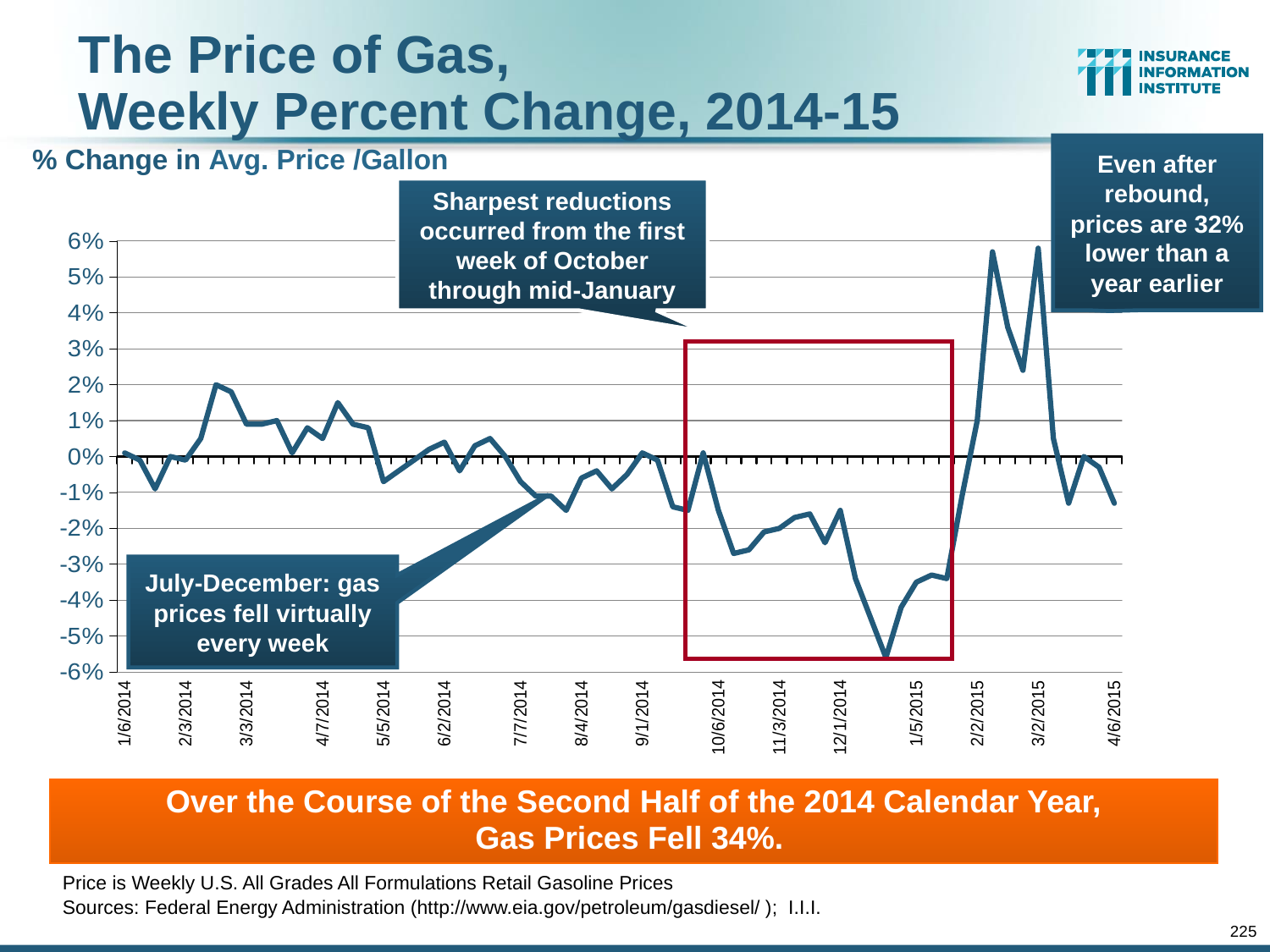
Between 3/2/2015 and 4/6/2015, does the line rise or fall? fall Is the value for 1/5/2015 greater or less than -2%? less What is the title of the chart on the slide? The Price of Gas, Weekly Percent Change, 2014-15 Is the value for 12/1/2014 greater or less than 0%? less How many date labels are shown along the x axis? 16 Is the value for 3/2/2015 greater or less than 4%? greater Between 1/5/2015 and 2/2/2015, does the line rise or fall? rise What kind of chart is shown on the slide? line chart What label is shown above the chart describing the plotted quantity? % Change in Avg. Price /Gallon